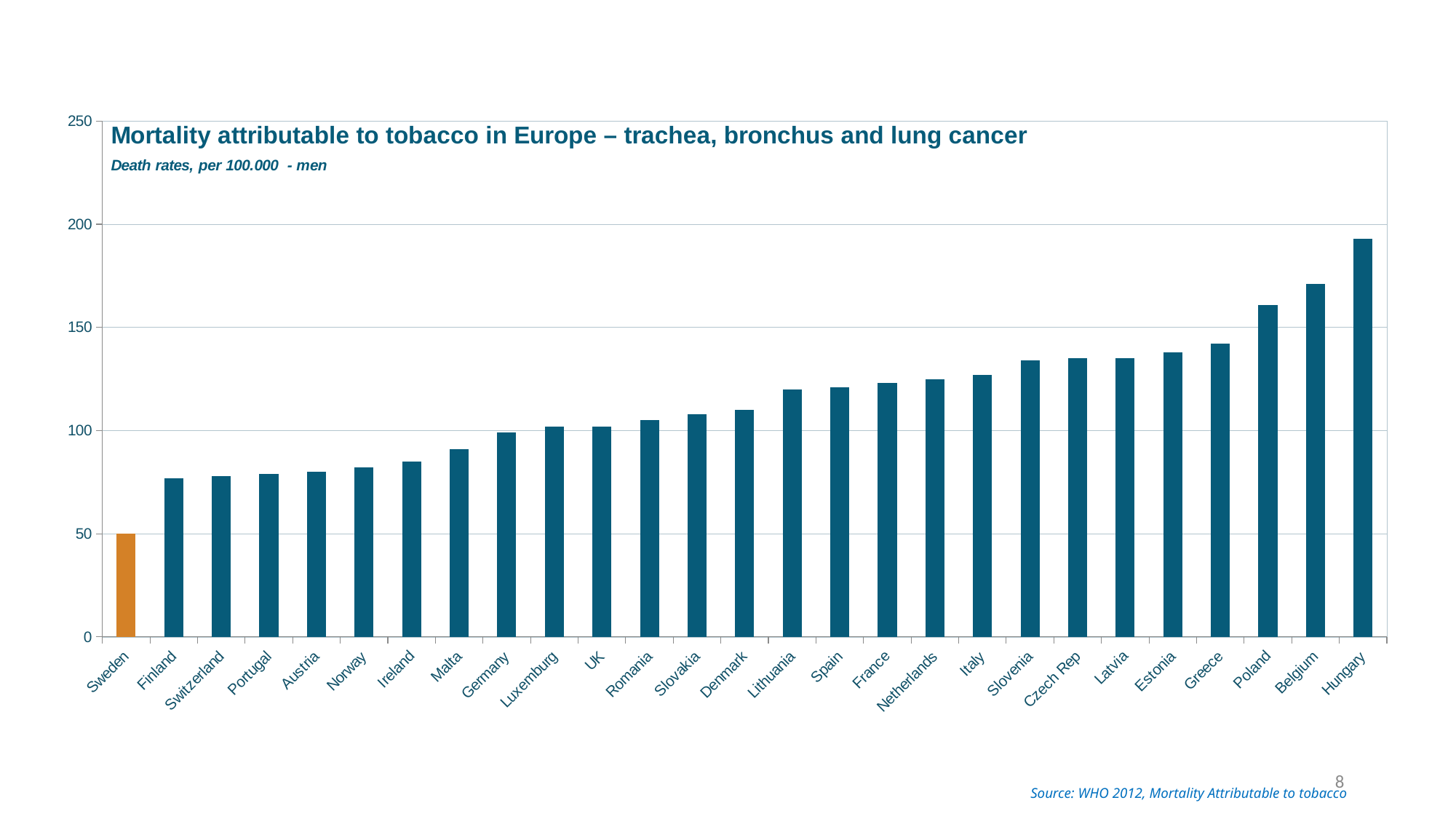
How many countries are shown in the chart? 27 Is the value for Finland greater or less than 100? less What is the death rate for Sweden? 50 Which country has the highest death rate in the chart? Hungary Is the value for Hungary greater or less than 150? greater Is the value for Greece greater or less than 150? less Which country has the lowest death rate in the chart? Sweden Which has a higher death rate, Poland or Hungary? Hungary Do the values rise or fall from left to right along the x axis? rise What kind of chart is shown on the slide? bar chart Which country's bar is shown in orange rather than blue? Sweden